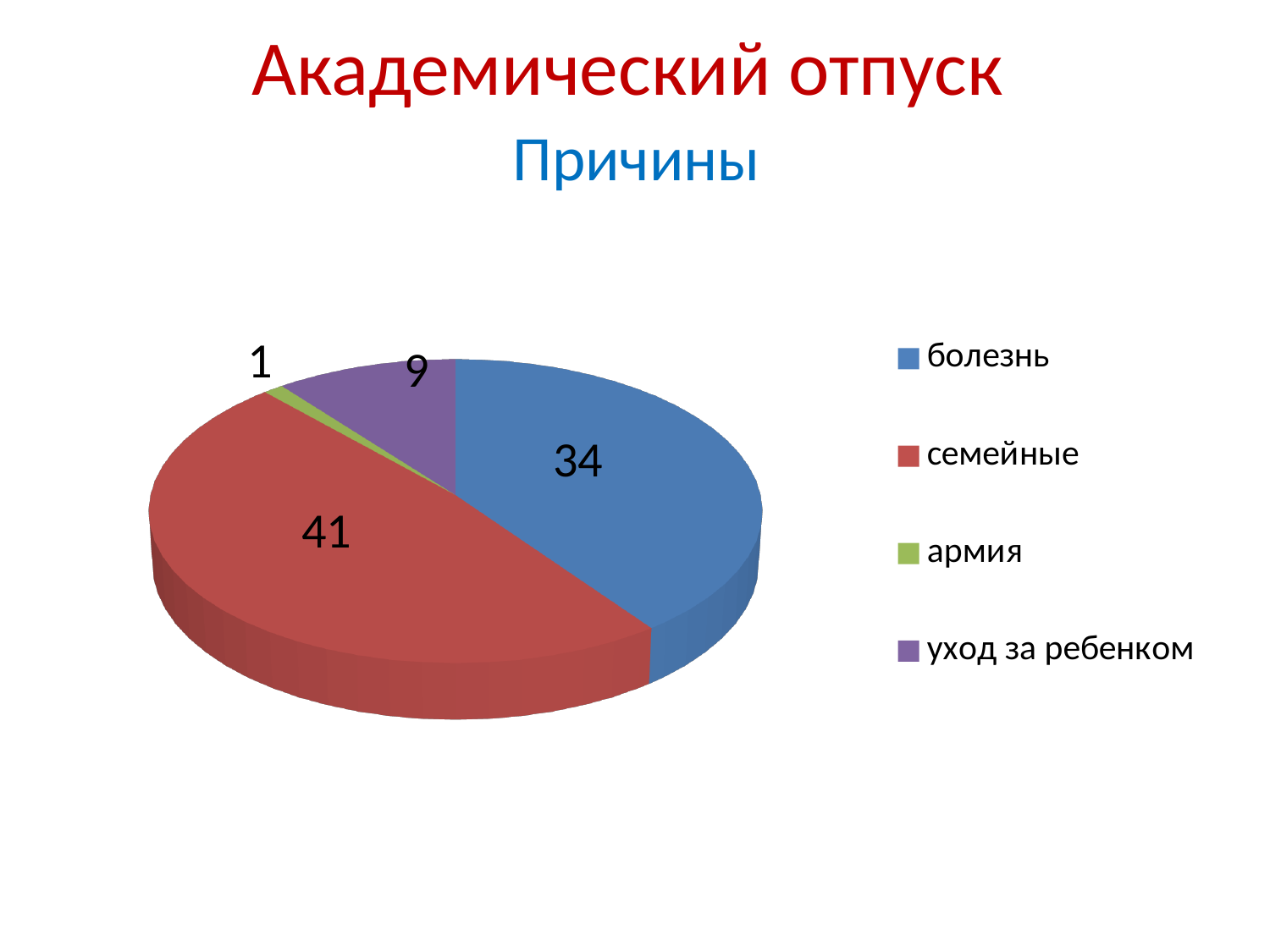
What share of the total does the болезнь slice represent? 40% What is the value for армия in the pie chart? 1 What is the value for семейные in the pie chart? 41 What is the difference between the values for семейные and болезнь? 7 What is the value for уход за ребенком in the pie chart? 9 What is the subtitle shown above the chart? Причины How many categories are shown in the pie chart? 4 Which is larger, the value for уход за ребенком or the value for армия? уход за ребенком Which category has the largest slice in the pie chart? семейные Which category has the smallest slice in the pie chart? армия What kind of chart is shown on the slide? pie chart What is the value for болезнь in the pie chart? 34